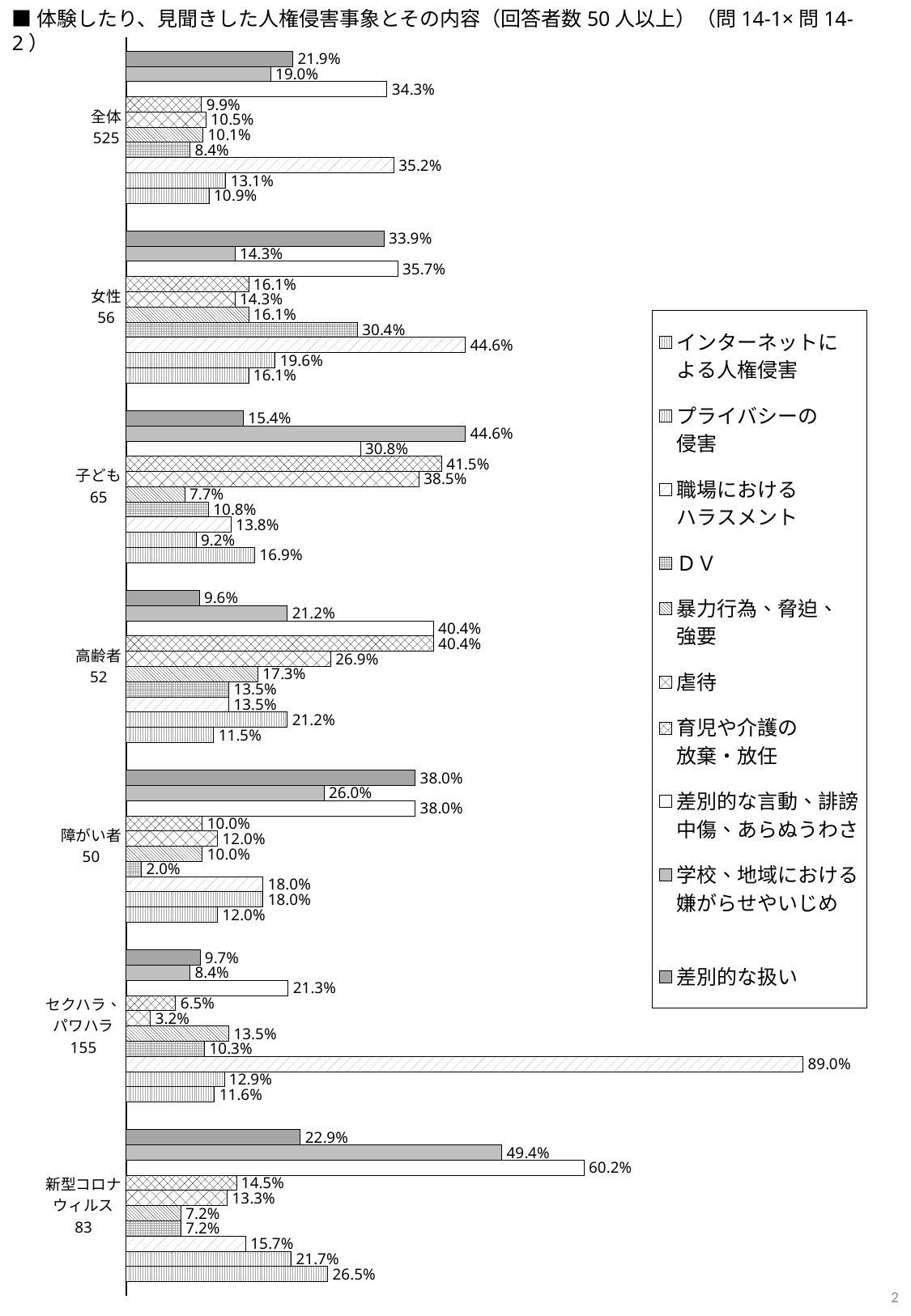
How many respondents are in the 全体 group? 525 Which bar has the highest value on the whole chart? 職場におけるハラスメント in セクハラ、パワハラ (89.0%) What is the value for 職場におけるハラスメント in the セクハラ、パワハラ group? 89.0% How many series does the legend list? 10 How many respondent groups (categories) are plotted on the chart? 7 In the 子ども group, what is the difference between 育児や介護の放棄・放任 (41.5%) and 虐待 (38.5%)? 3.0 percentage points Which item has the lowest value in the 障がい者 group? ＤＶ (2.0%) What kind of chart is shown on the slide? bar chart What is the value for 差別的な言動、誹謗中傷、あらぬうわさ in the 新型コロナウィルス group? 60.2% Which is larger: 差別的な扱い for 女性 or 差別的な扱い for 全体? 女性 What is the value for 差別的な扱い in the 高齢者 group? 9.6% What is the value for 学校、地域における嫌がらせやいじめ in the 新型コロナウィルス group? 49.4%